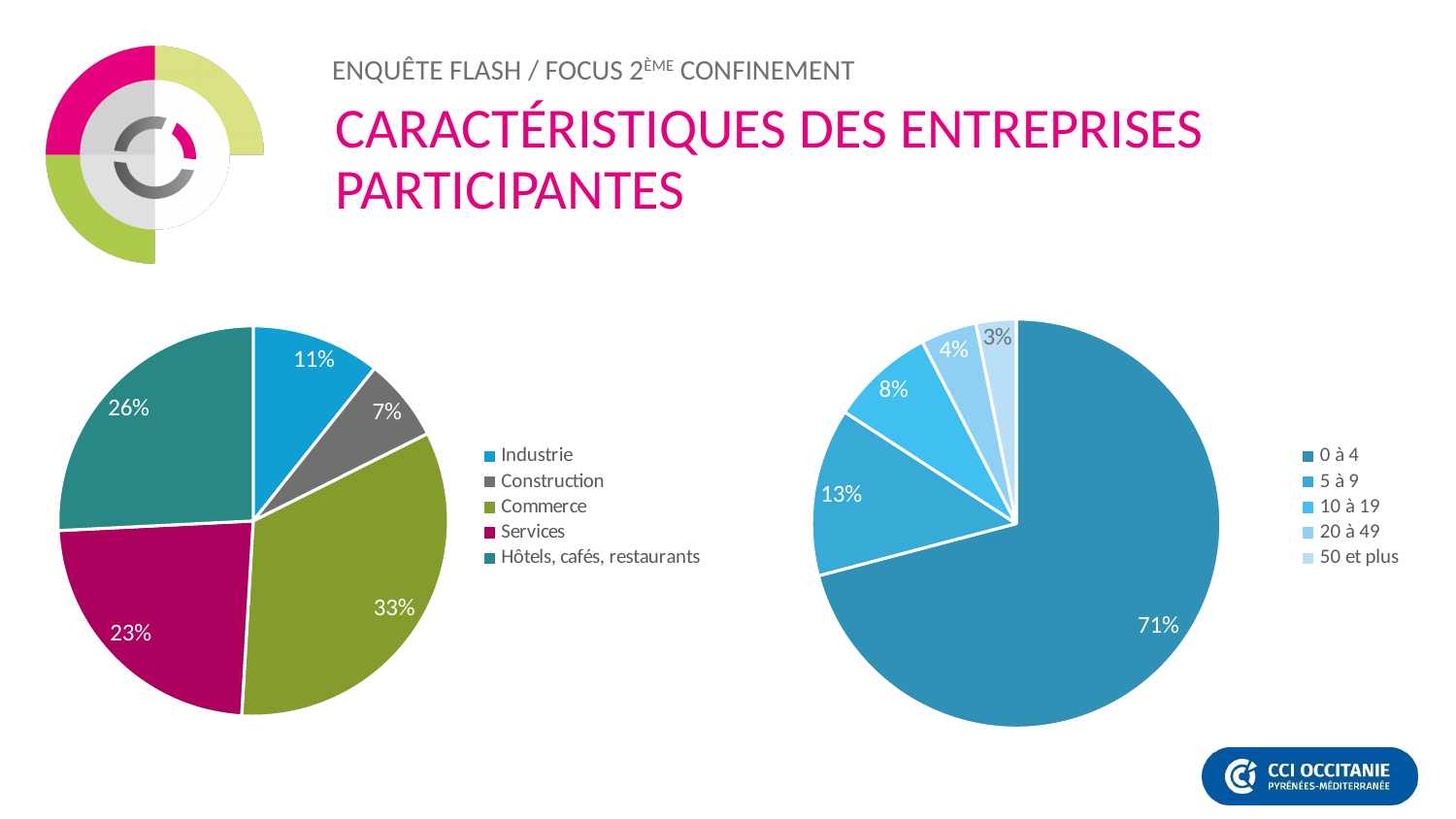
In the left pie chart, what share does Construction have? 7% How many categories does the left pie chart's legend list? 5 What type of chart is the right chart on the slide? Pie chart In the right pie chart, what share does the 10 à 19 category have? 8% In the left pie chart, which category has the smallest share? Construction In the right pie chart, which category has the smallest share? 50 et plus In the right pie chart, what is the difference between the shares of 5 à 9 and 20 à 49? 9% In the right pie chart, what share does the 0 à 4 category have? 71% In the left pie chart, which category has the largest share? Commerce In the left pie chart, what share does Commerce have? 33% In the left pie chart, what is the difference between the shares of Hôtels, cafés, restaurants and Services? 3% In the left pie chart, which is larger: Industrie or Services? Services